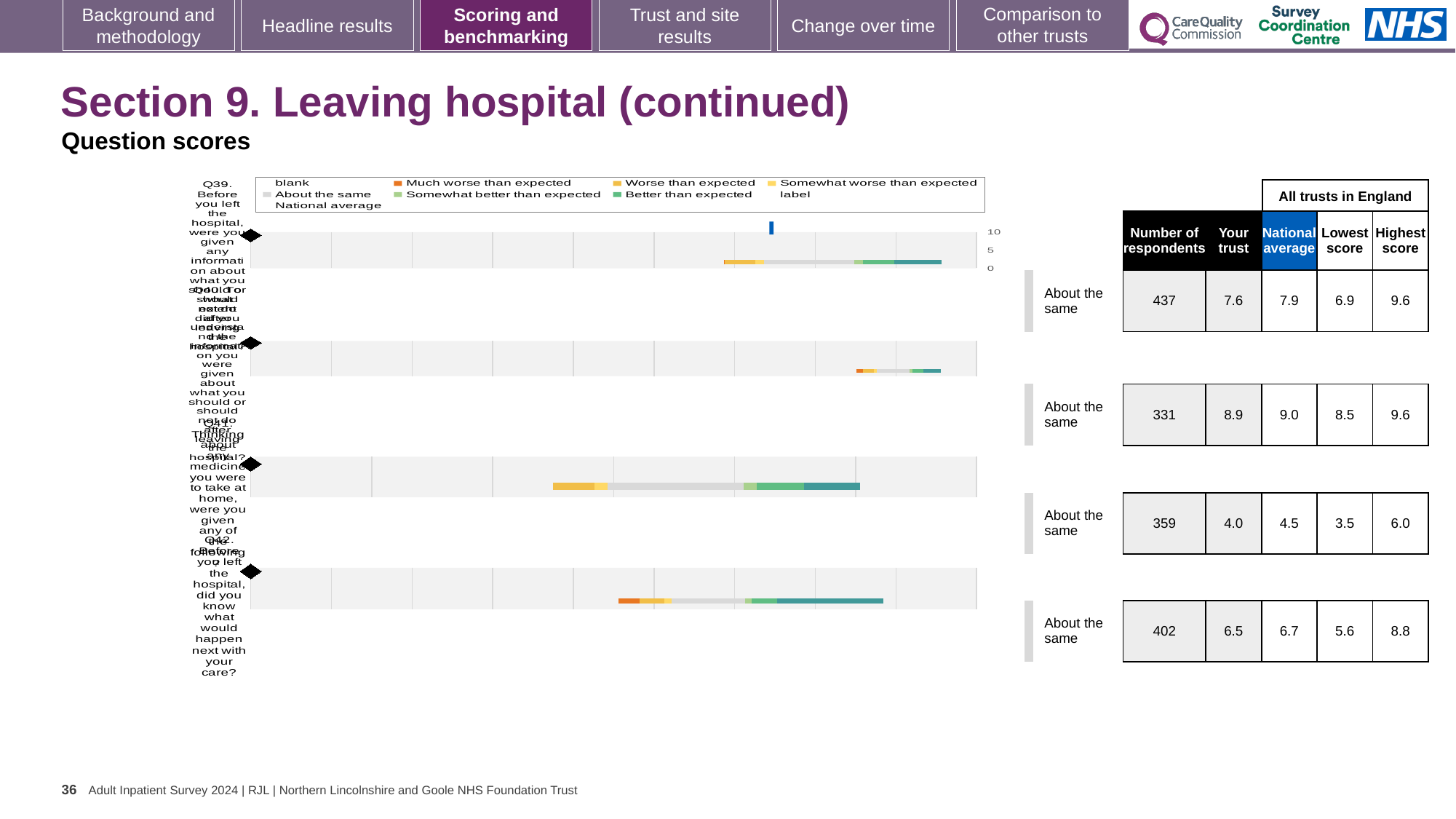
In the table next to the chart, what is the 'Your trust' score for Q39? 7.6 Which legend entry is shown in orange in the chart legend? Much worse than expected In the table next to the chart, what is the highest score for Q42? 8.8 What kind of chart is used to show the question scores on this slide? bar chart In the table next to the chart, is the 'Your trust' score for Q42 larger or smaller than the national average for Q42? smaller Which legend entry is shown in light grey in the chart legend? About the same In the table next to the chart, what is the national average for Q40? 9.0 In the table next to the chart, how many respondents answered Q41? 359 How many questions (bars) are plotted in the chart? 4 In the table next to the chart, which question has the lowest 'Your trust' score? Q41 In the table next to the chart, which question has the highest 'Your trust' score? Q40 In the table next to the chart, what is the difference between the national average and the 'Your trust' score for Q41? 0.5